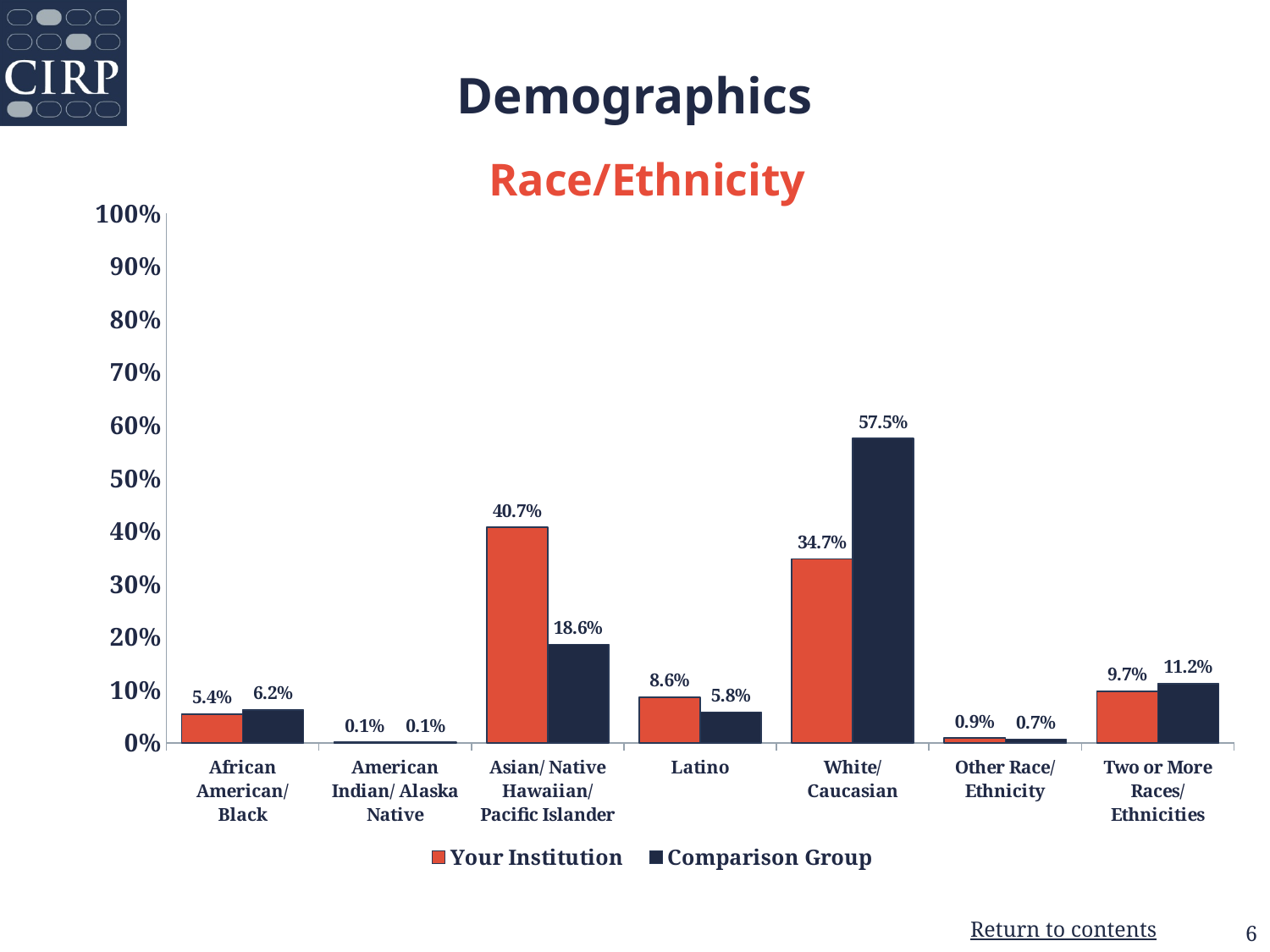
Which category has the lowest Your Institution value? American Indian/Alaska Native What is the Your Institution value for Latino? 8.6% What is the title of the chart? Race/Ethnicity Which category has the highest Comparison Group value? White/Caucasian How many series does the legend list? 2 What is the Comparison Group value for Two or More Races/Ethnicities? 11.2% What is the Your Institution value for Asian/Native Hawaiian/Pacific Islander? 40.7% What kind of chart is shown on the slide? Bar chart What is the Comparison Group value for White/Caucasian? 57.5% What is the difference between the Comparison Group and Your Institution values for White/Caucasian? 22.8% Which is larger for Asian/Native Hawaiian/Pacific Islander: Your Institution or Comparison Group? Your Institution How many race/ethnicity categories are shown on the x axis? 7